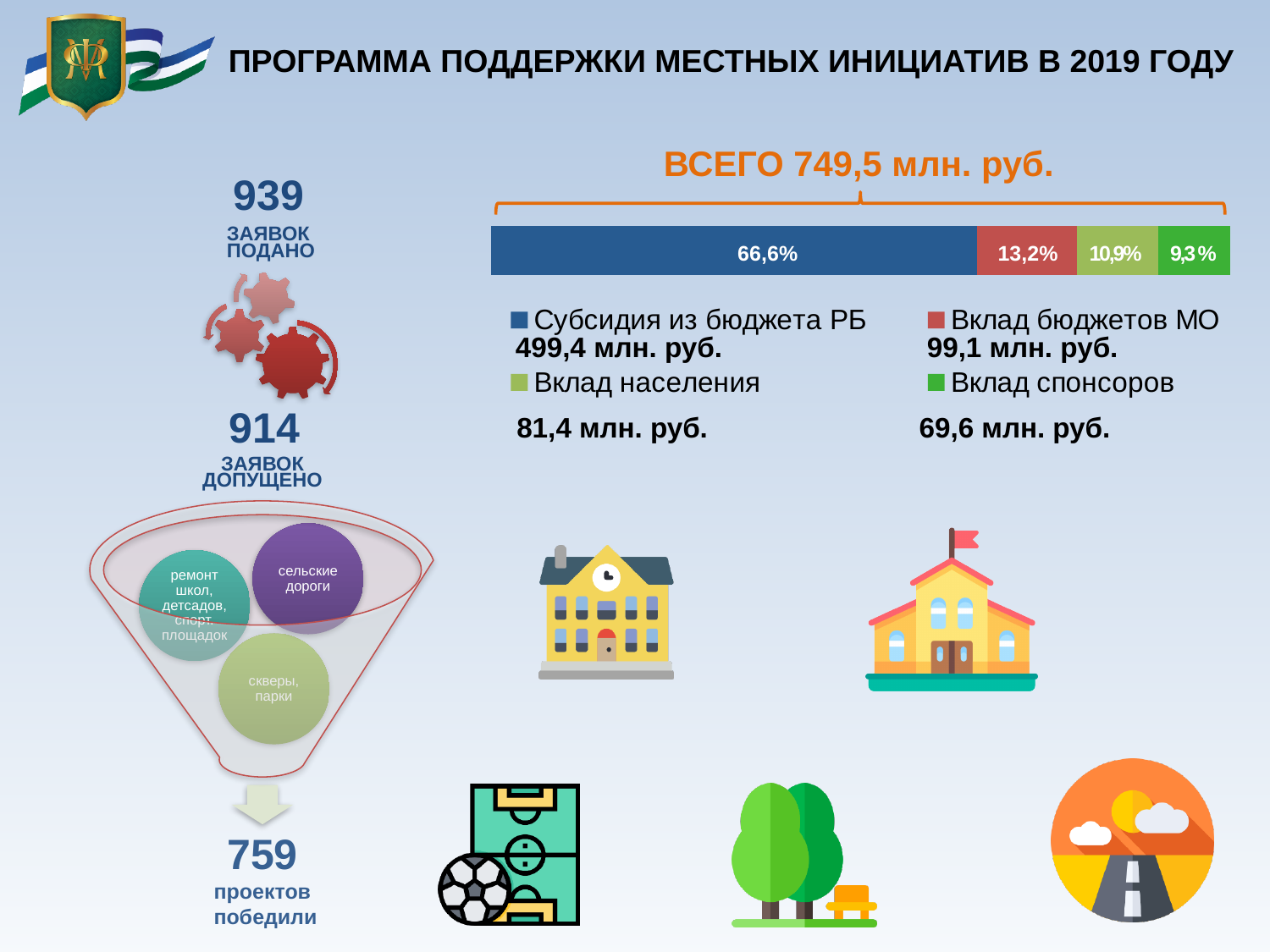
What is the difference in percentage points between 'Субсидия из бюджета РБ' and 'Вклад бюджетов МО'? 53,4 What percentage share does the segment 'Вклад бюджетов МО' have in the stacked bar? 13,2% What percentage share does the segment 'Субсидия из бюджета РБ' have in the stacked bar? 66,6% What percentage share does the segment 'Вклад спонсоров' have in the stacked bar? 9,3% What amount in млн. руб. is shown for 'Вклад населения' in the legend? 81,4 млн. руб. Which funding source has the smallest share in the stacked bar? Вклад спонсоров Which funding source has the largest share in the stacked bar? Субсидия из бюджета РБ What kind of chart is used to show the funding breakdown? Stacked bar chart What total amount is shown above the stacked bar? ВСЕГО 749,5 млн. руб. How many series does the legend of the stacked bar chart list? 4 What percentage share does the segment 'Вклад населения' have in the stacked bar? 10,9% Which is larger: the share of 'Вклад населения' or the share of 'Вклад спонсоров'? Вклад населения